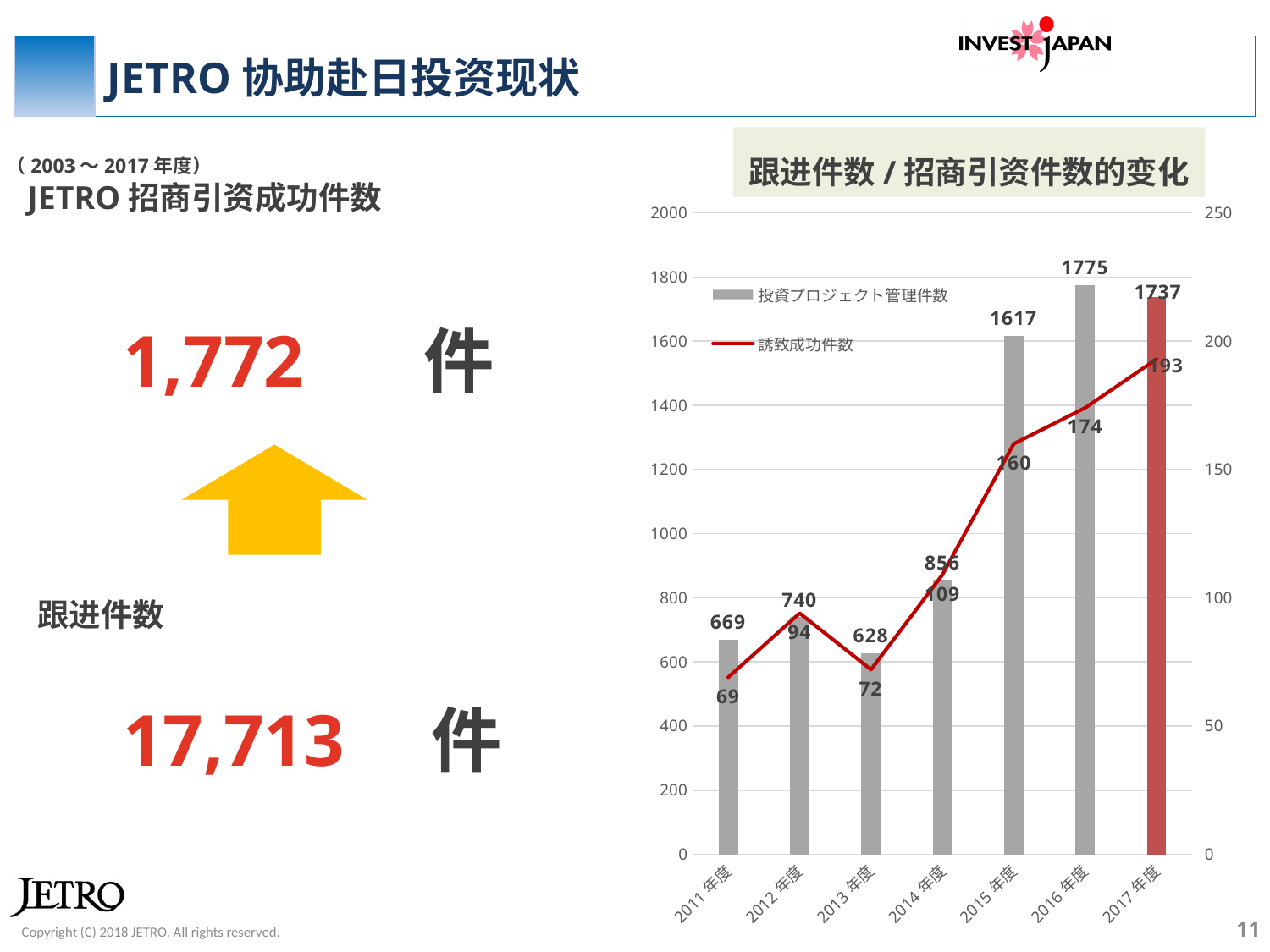
Is the 投資プロジェクト管理件数 value for 2015年度 greater or less than 1400? greater What is the value of 投資プロジェクト管理件数 for 2013年度? 628 Which year has the lowest value of 誘致成功件数? 2011年度 Which is larger, the 誘致成功件数 value for 2012年度 or for 2013年度? 2012年度 What is the difference between the 投資プロジェクト管理件数 values for 2016年度 and 2017年度? 38 Which year has the highest value of 投資プロジェクト管理件数? 2016年度 What kind of chart is shown on the slide? Combined bar and line chart What is the title of the chart? 跟进件数 / 招商引资件数的变化 What is the value of 誘致成功件数 for 2017年度? 193 How many series does the chart legend list? 2 How many years are shown on the x axis of the chart? 7 What is the value of 投資プロジェクト管理件数 for 2016年度? 1775